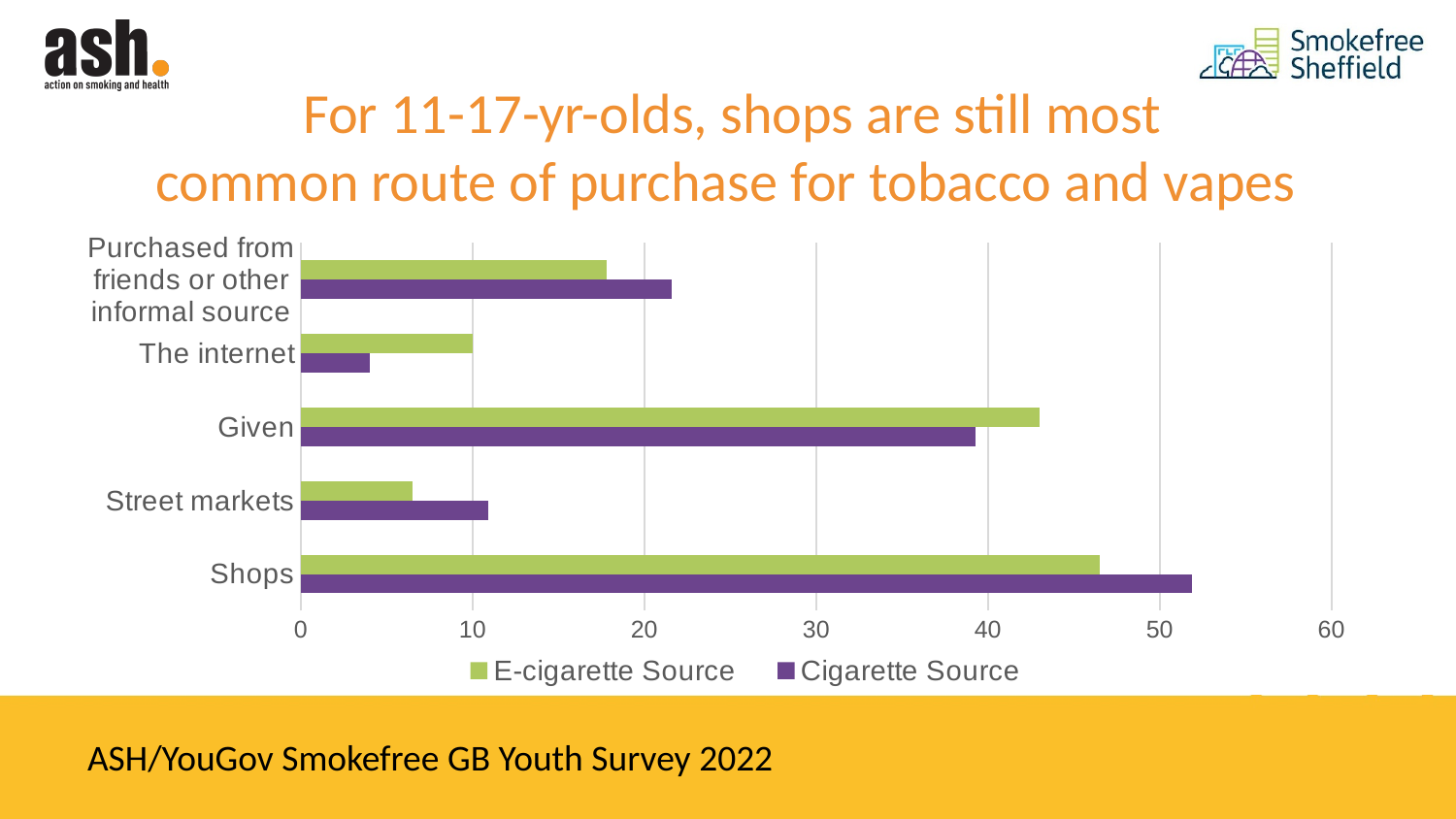
Which category has the lowest value for E-cigarette Source? Street markets Which category has the lowest value for Cigarette Source? The internet Is the Cigarette Source value for The internet greater or less than 10? less Which category has the highest value for E-cigarette Source? Shops Is the Cigarette Source value for Shops greater or less than 50? greater Is the E-cigarette Source value for Given greater or less than 40? greater Which category has the highest value for Cigarette Source? Shops What kind of chart is shown on the slide? bar chart For The internet, which is larger: the E-cigarette Source value or the Cigarette Source value? E-cigarette Source For Shops, which is larger: the E-cigarette Source value or the Cigarette Source value? Cigarette Source How many series does the legend list? 2 How many categories are shown on the chart? 5